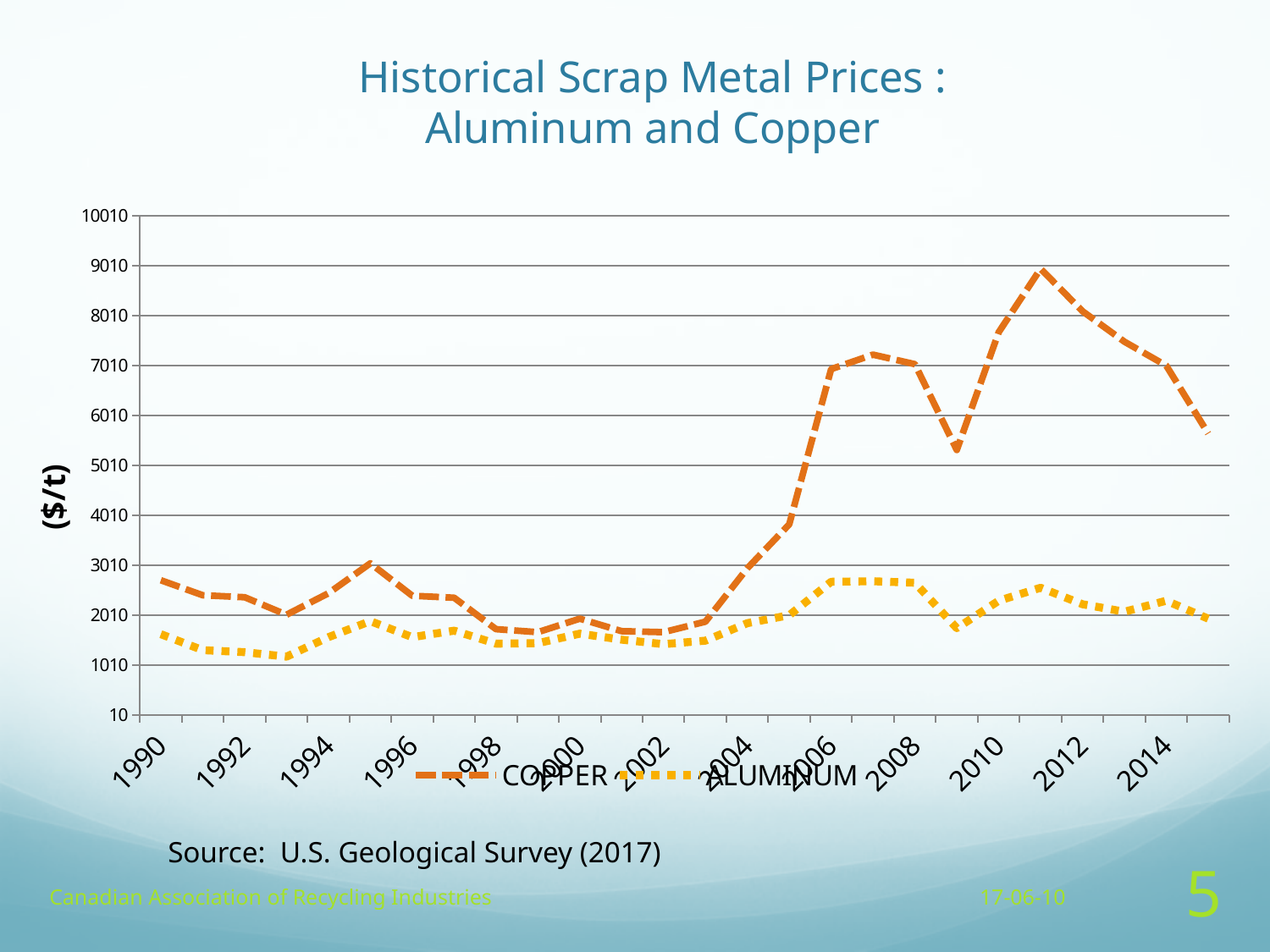
Is the ALUMINUM value for 1993 greater or less than 2010? less Does the COPPER series rise or fall from 2011 to 2015? fall Is the COPPER value for 2009 greater or less than 6010? less How many series does the legend list? 2 In which year does the COPPER series reach its highest value? 2011 What kind of chart is shown on the slide? line chart Is the COPPER value for 2011 greater or less than 8010? greater What are the two series named in the legend? COPPER and ALUMINUM In 2011, which series has the higher value, COPPER or ALUMINUM? COPPER What is the label on the vertical axis? ($/t)